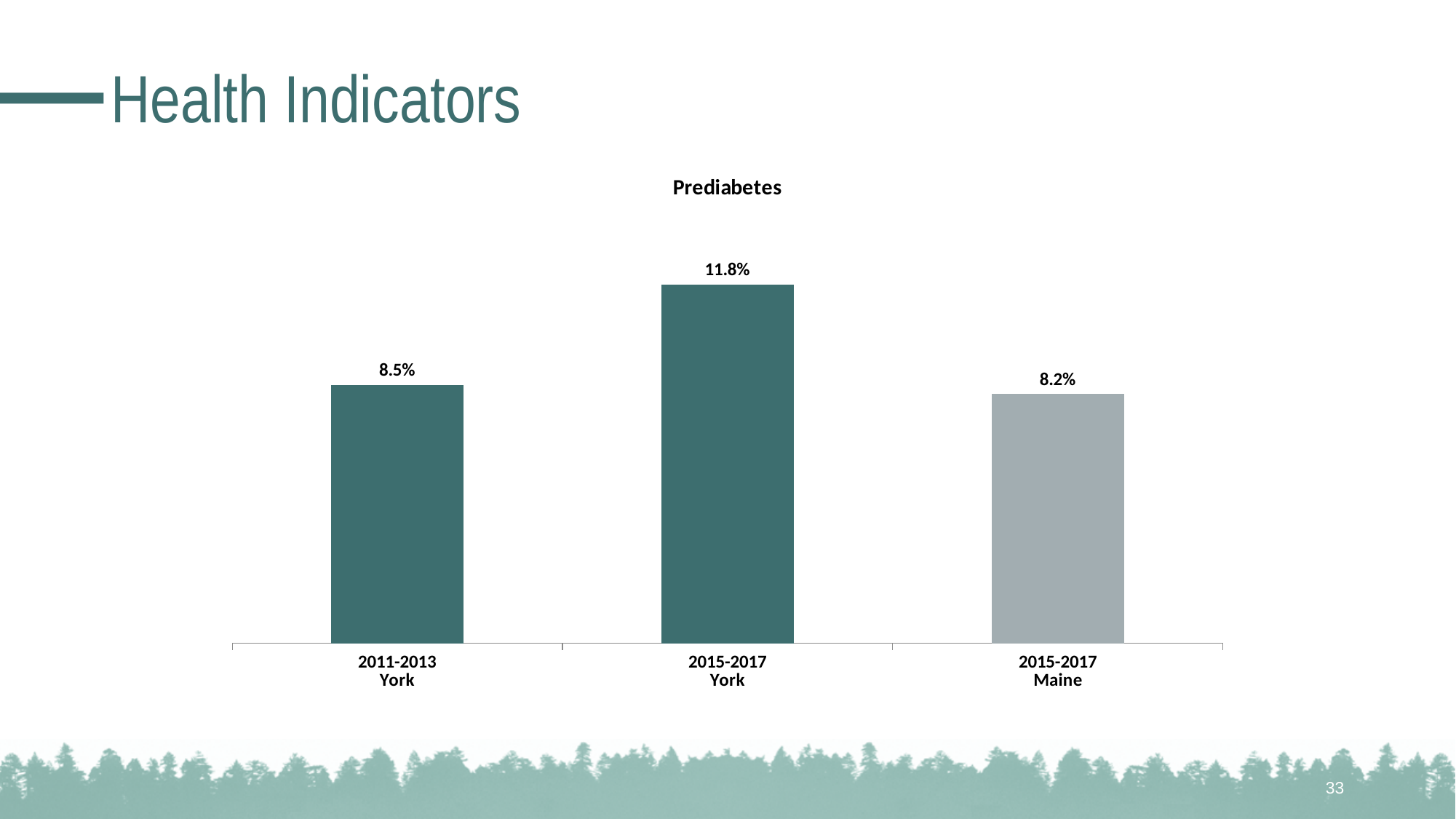
What is the prediabetes value for 2015-2017 Maine? 8.2% What kind of chart is shown on the slide? Bar chart How many bars are shown in the chart? 3 Which is larger, the prediabetes value for 2015-2017 York or 2015-2017 Maine? 2015-2017 York Which category has the highest prediabetes value? 2015-2017 York What is the prediabetes value for 2015-2017 York? 11.8% What is the title of the chart? Prediabetes What is the prediabetes value for 2011-2013 York? 8.5% Which category has the lowest prediabetes value? 2015-2017 Maine What is the difference between the prediabetes values for 2015-2017 York and 2011-2013 York? 3.3% Which bar is shown in grey rather than teal? 2015-2017 Maine What is the difference between the prediabetes values for 2015-2017 York and 2015-2017 Maine? 3.6%